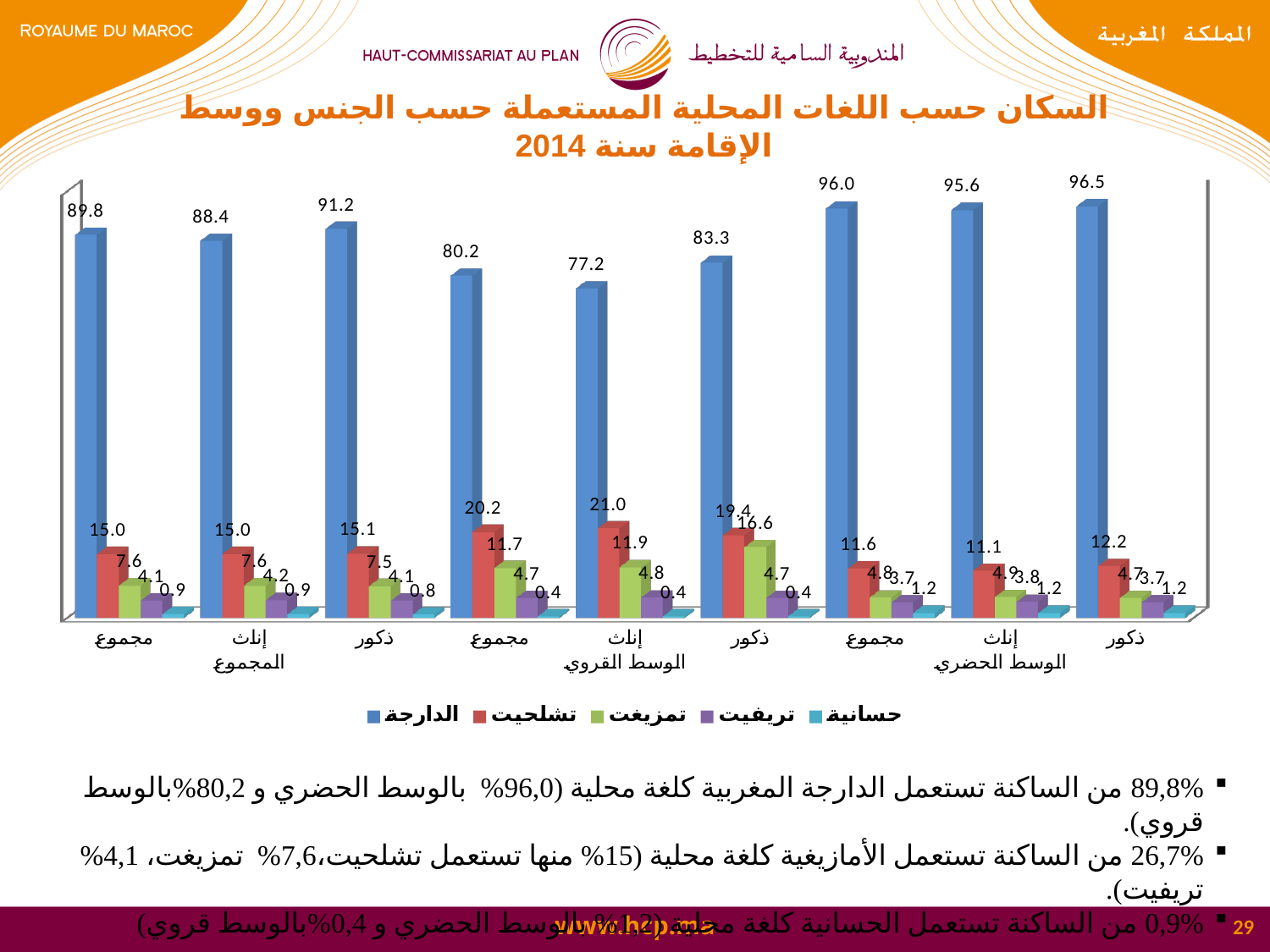
What type of chart is shown on the slide? bar chart How many categories are shown on the x axis? 9 How many series does the legend list? 5 Which category has the highest value for الدارجة? ذكور (الوسط الحضري) Which category has the lowest value for الدارجة? إناث (الوسط القروي) What is the difference between the الدارجة values for مجموع in الوسط الحضري and مجموع in الوسط القروي? 15.8 What is the value of تشلحيت for إناث in الوسط القروي? 21.0 What is the value of الدارجة for مجموع in المجموع? 89.8 Which is larger: تشلحيت for ذكور in الوسط القروي or تشلحيت for ذكور in الوسط الحضري? ذكور in الوسط القروي What is the value of تمزيغت for ذكور in الوسط القروي? 16.6 What is the value of حسانية for مجموع in الوسط الحضري? 1.2 Which series is shown in blue in the legend? الدارجة